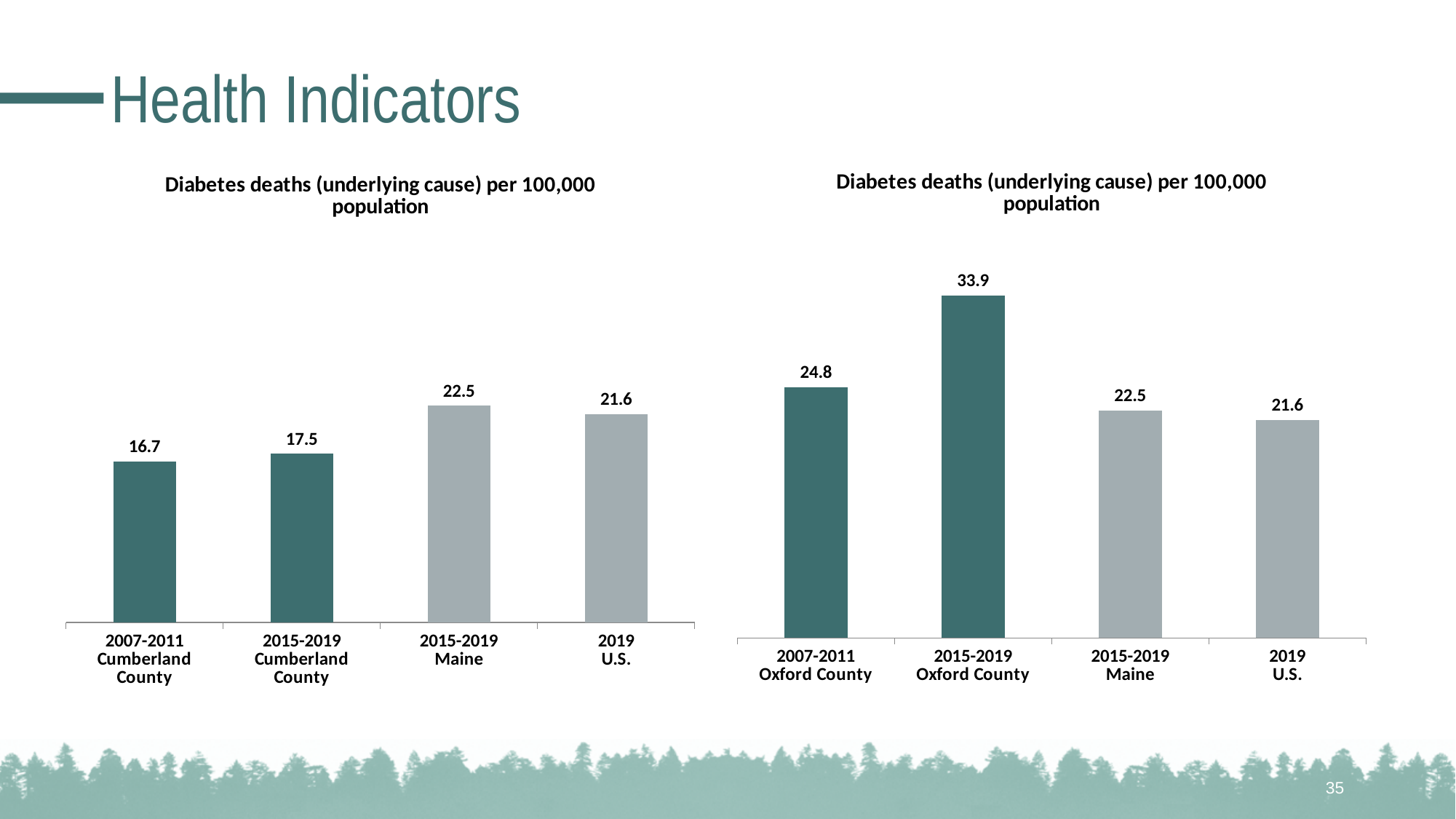
In the right chart (Oxford County), what is the difference between 2015-2019 Oxford County and 2007-2011 Oxford County? 9.1 In the left chart (Cumberland County), what is the value for 2007-2011 Cumberland County? 16.7 How many bars are in the left chart (Cumberland County)? 4 What type of chart is the right chart (Oxford County)? Bar chart In the left chart (Cumberland County), which category has the lowest value? 2007-2011 Cumberland County In the left chart (Cumberland County), what is the value for 2015-2019 Cumberland County? 17.5 In the left chart (Cumberland County), which category has the highest value? 2015-2019 Maine In the right chart (Oxford County), what is the value for 2007-2011 Oxford County? 24.8 In the right chart (Oxford County), what is the value for 2015-2019 Oxford County? 33.9 In the right chart (Oxford County), which category has the highest value? 2015-2019 Oxford County In the right chart (Oxford County), which is larger: 2015-2019 Oxford County or 2019 U.S.? 2015-2019 Oxford County In the left chart (Cumberland County), what is the difference between 2015-2019 Maine and 2015-2019 Cumberland County? 5.0